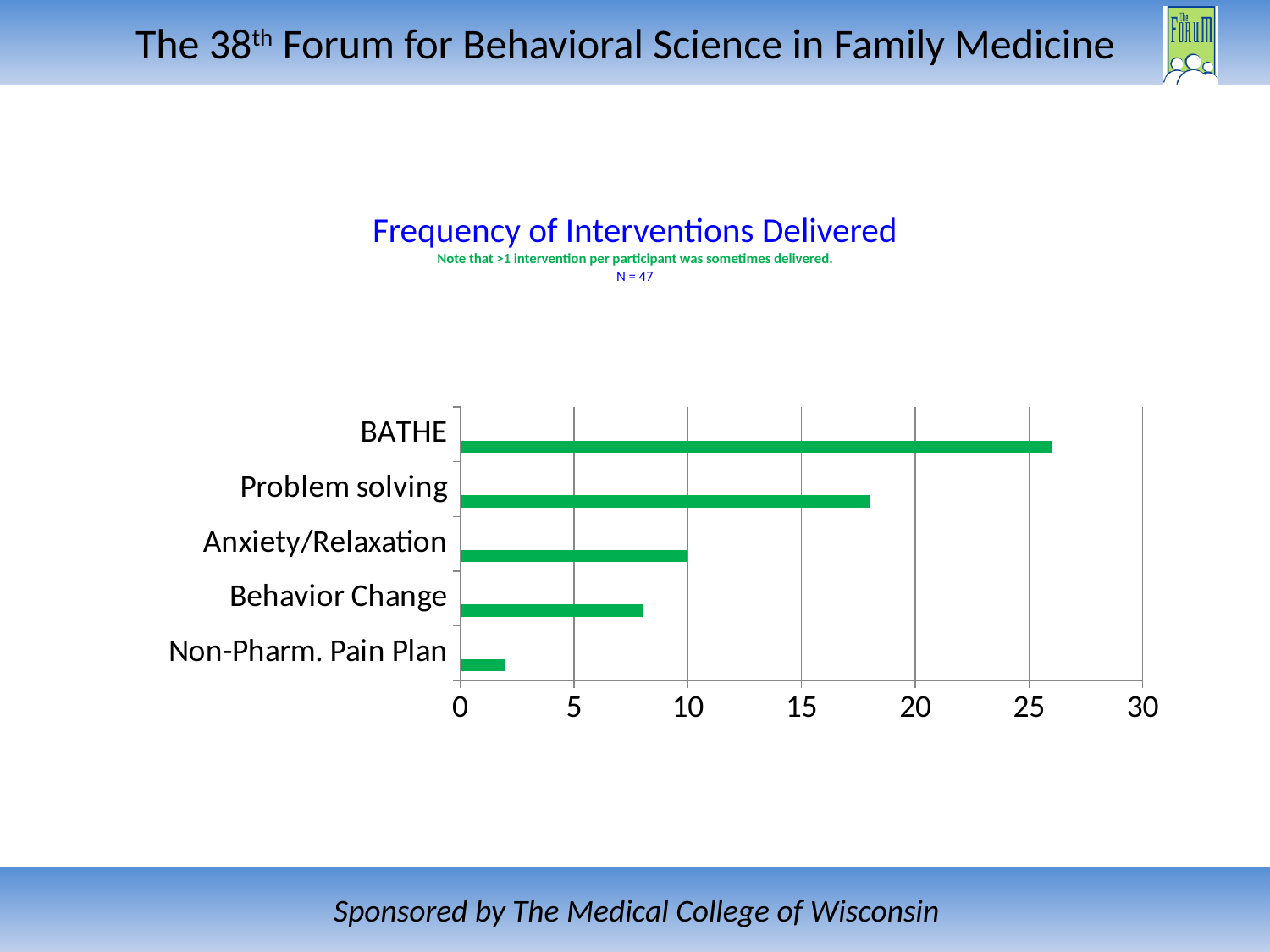
What N value is stated below the chart title? N = 47 Which is larger, the value for Problem solving or the value for Behavior Change? Problem solving Is the value for Non-Pharm. Pain Plan greater or less than 5? less Is the value for Behavior Change greater or less than 10? less What is the title of the chart? Frequency of Interventions Delivered Is the value for BATHE greater or less than 25? greater How many intervention categories are plotted in the chart? 5 What is the value for Anxiety/Relaxation? 10 Which intervention has the highest frequency? BATHE What kind of chart is shown on the slide? bar chart Which intervention has the lowest frequency? Non-Pharm. Pain Plan